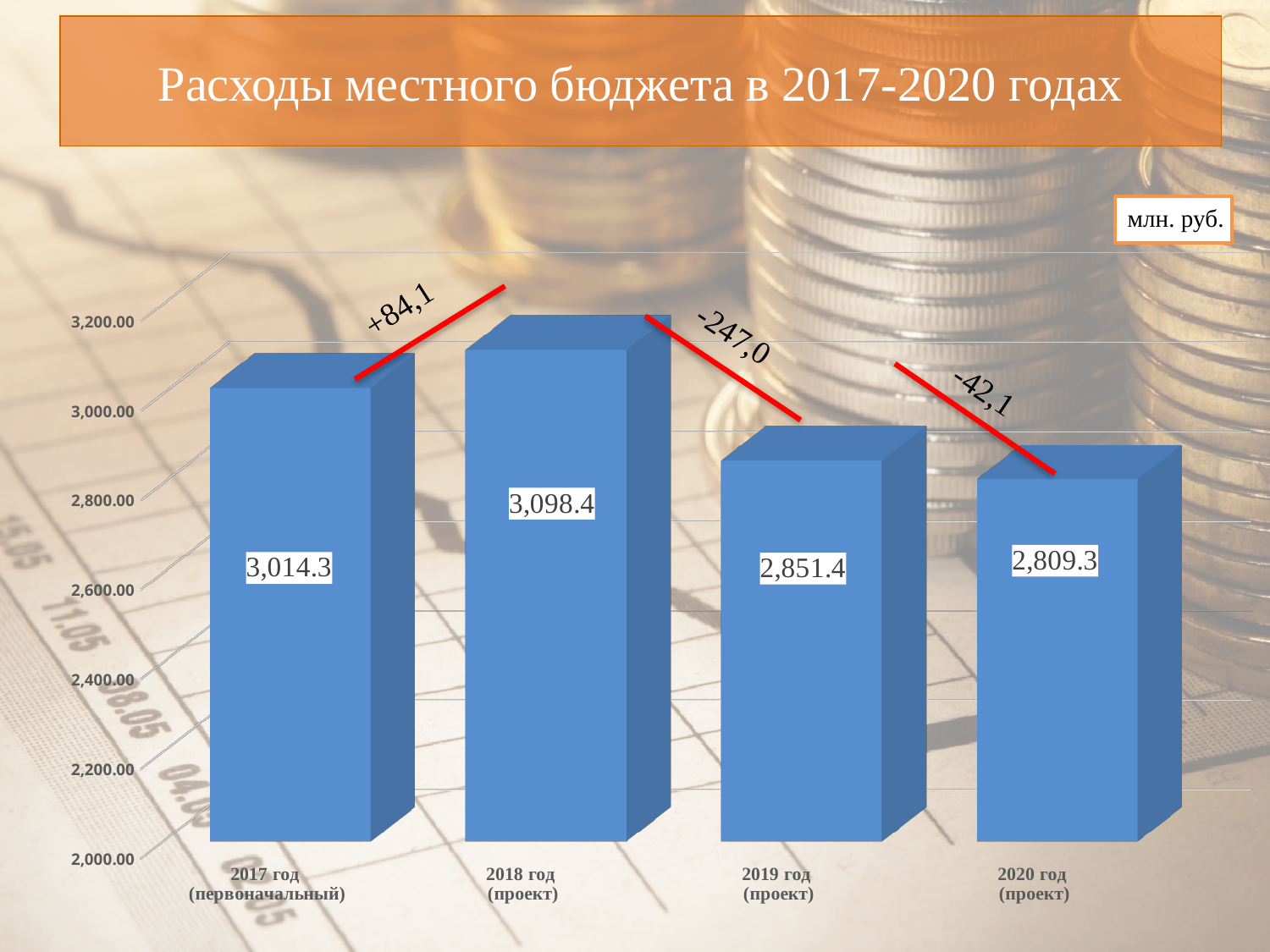
How many bars are shown in the chart? 4 What is the value for 2018 год (проект)? 3,098.4 What is the difference between the values for 2018 год (проект) and 2019 год (проект)? 247.0 What unit of measurement is indicated for the chart? млн. руб. What is the value for 2020 год (проект)? 2,809.3 Which year has the lowest expenditure? 2020 год (проект) Which year has the highest expenditure? 2018 год (проект) What kind of chart is shown on the slide? bar chart What is the difference between the values for 2019 год (проект) and 2020 год (проект)? 42.1 Is the value for 2019 год (проект) greater or less than 3,000.00? less What is the value for 2017 год (первоначальный)? 3,014.3 Which is larger, the value for 2017 год (первоначальный) or 2019 год (проект)? 2017 год (первоначальный)